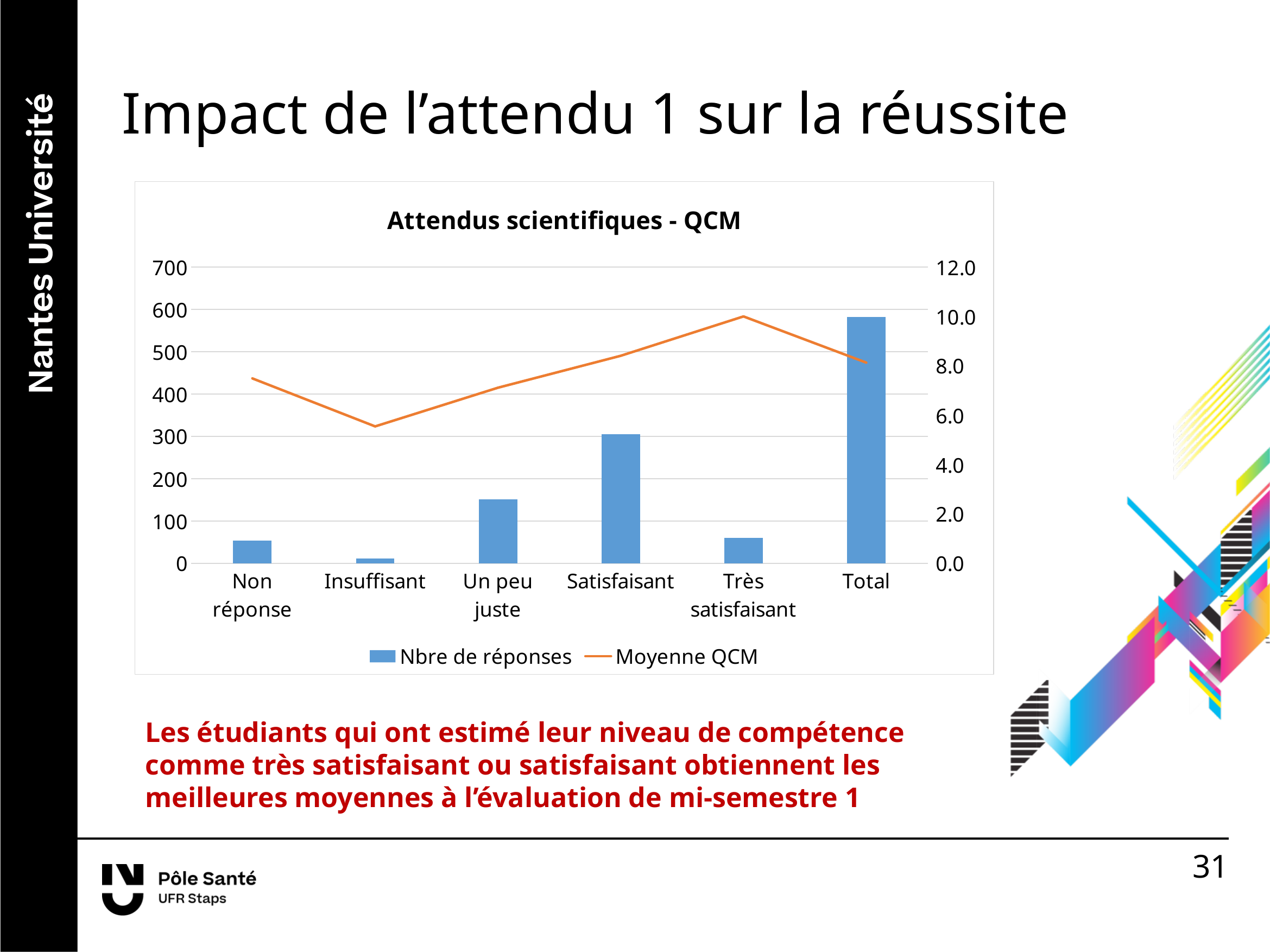
How many series does the legend list? 2 Which category has the lowest number of responses (Nbre de réponses)? Insuffisant Which has more responses, Satisfaisant or Un peu juste? Satisfaisant Is the Moyenne QCM for Très satisfaisant greater or less than 8.0? greater Which category has the highest Moyenne QCM? Très satisfaisant Which category has the lowest Moyenne QCM? Insuffisant Is the number of responses for Un peu juste greater or less than 200? less What kind of chart is shown on the slide? A combined bar and line chart Which category has the highest number of responses (Nbre de réponses)? Total How many categories are shown on the x axis? 6 What is the title of the chart? Attendus scientifiques - QCM Is the number of responses for Satisfaisant greater or less than 200? greater